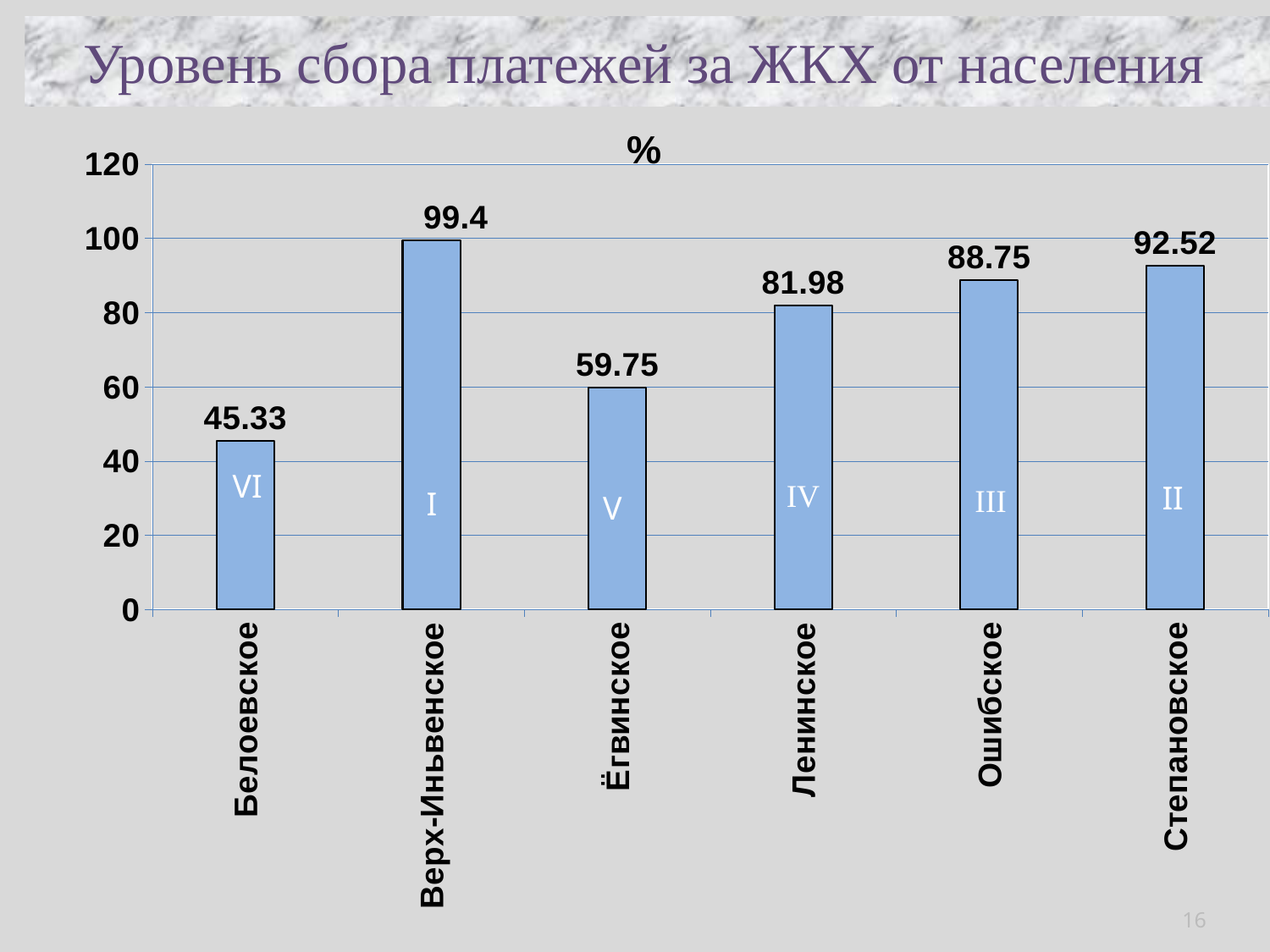
What kind of chart is shown on the slide? bar chart Is the value for Ошибское greater or less than 80? greater Which category has the highest value? Верх-Иньвенское What is the value for Ленинское? 81.98 How many categories are shown on the chart? 6 What is the value for Верх-Иньвенское? 99.4 What rank label is printed inside the bar for Ёгвинское? V What is the difference between the values for Степановское and Ошибское? 3.77 What is the value for Белоевское? 45.33 Which category has the lowest value? Белоевское What is the title of the chart? % Which is larger, the value for Ёгвинское or the value for Ленинское? Ленинское